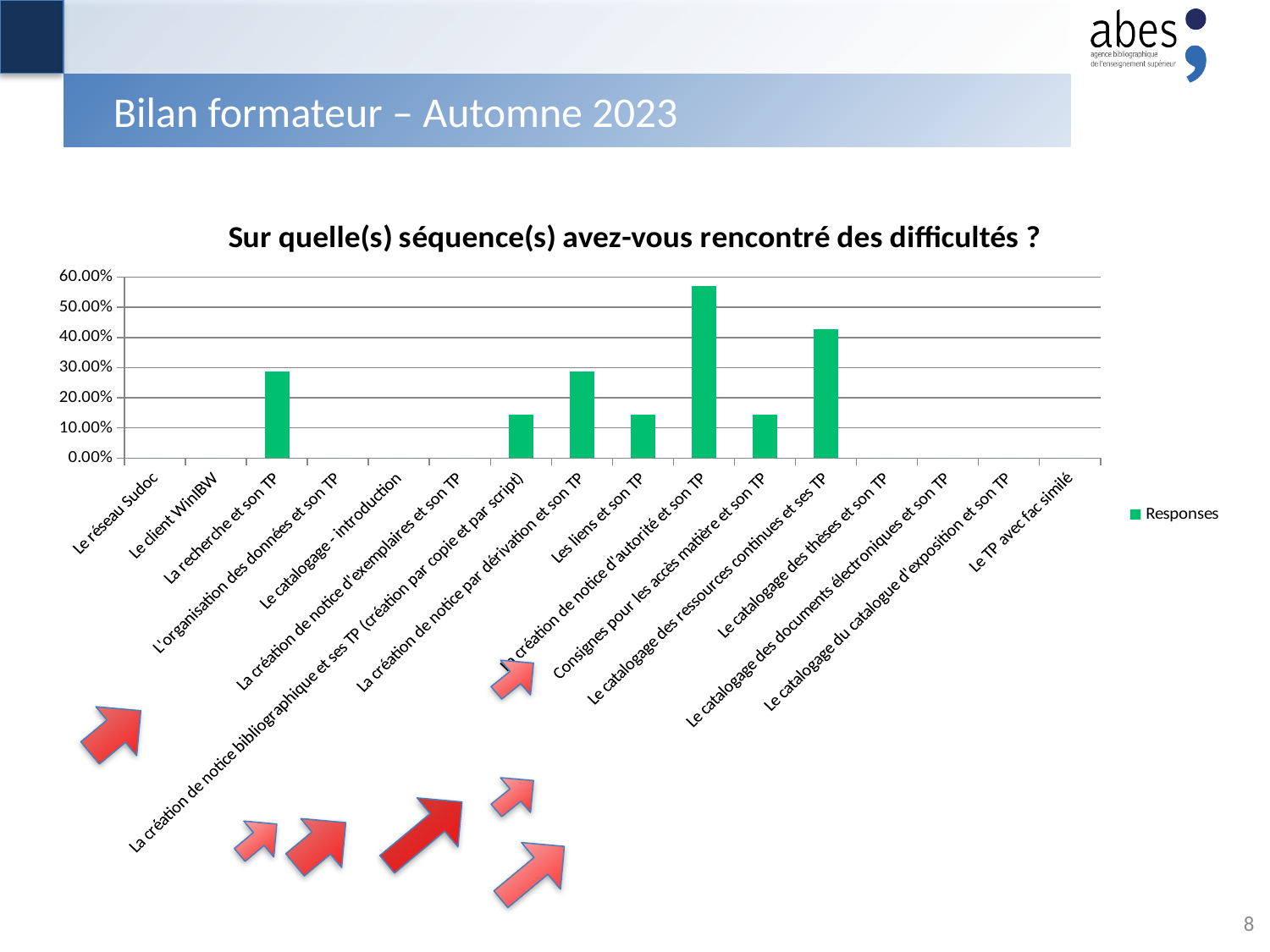
Is the value for 'La création de notice d'autorité et son TP' greater or less than 50.00%? greater Which is larger, the value for 'La création de notice d'autorité et son TP' or the value for 'Le catalogage des ressources continues et ses TP'? La création de notice d'autorité et son TP What is the title of the chart? Sur quelle(s) séquence(s) avez-vous rencontré des difficultés ? What is the name of the series shown in the legend? Responses What kind of chart is shown on the slide? bar chart Is the value for 'Les liens et son TP' greater or less than 20.00%? less Which is larger, the value for 'La recherche et son TP' or the value for 'Les liens et son TP'? La recherche et son TP Is the value for 'Le catalogage des ressources continues et ses TP' greater or less than 40.00%? greater How many series does the legend list? 1 How many categories are shown on the x axis? 16 Which category has the highest value? La création de notice d'autorité et son TP